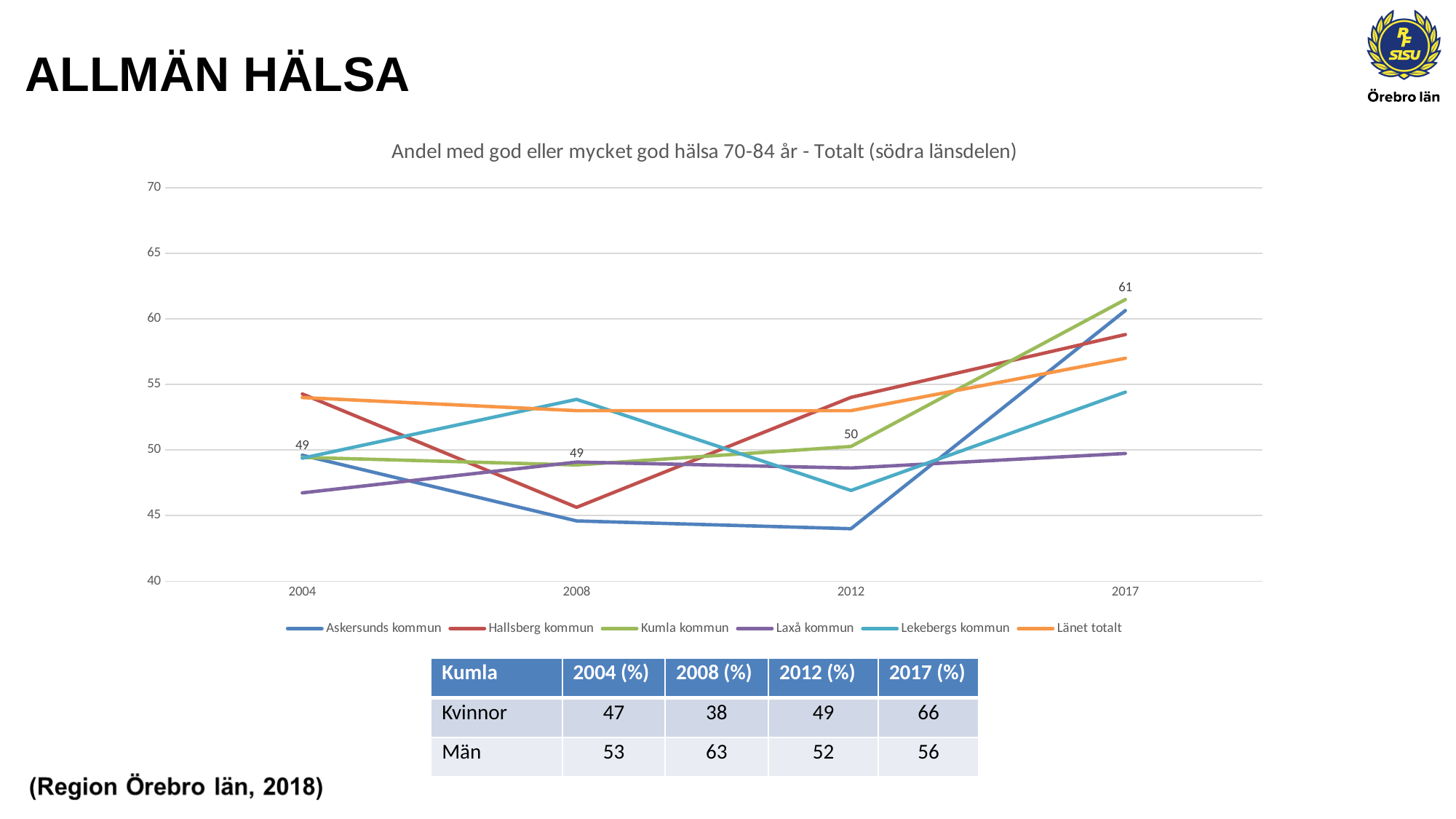
What is the value for Kumla kommun in 2012? 50 What is the value for Kumla kommun in 2004? 49 What kind of chart is shown on the slide? line chart Which series has the lowest value in 2017? Laxå kommun By how much did the value for Kumla kommun increase from 2012 to 2017? 11 Which series has the lowest value in 2012? Askersunds kommun In 2004, which is larger: Länet totalt or Laxå kommun? Länet totalt How many years are shown on the x axis? 4 What is the value for Kumla kommun in 2017? 61 How many series does the legend list? 6 Is the value for Hallsberg kommun in 2008 greater or less than 50? less Is the value for Askersunds kommun in 2012 greater or less than 45? less